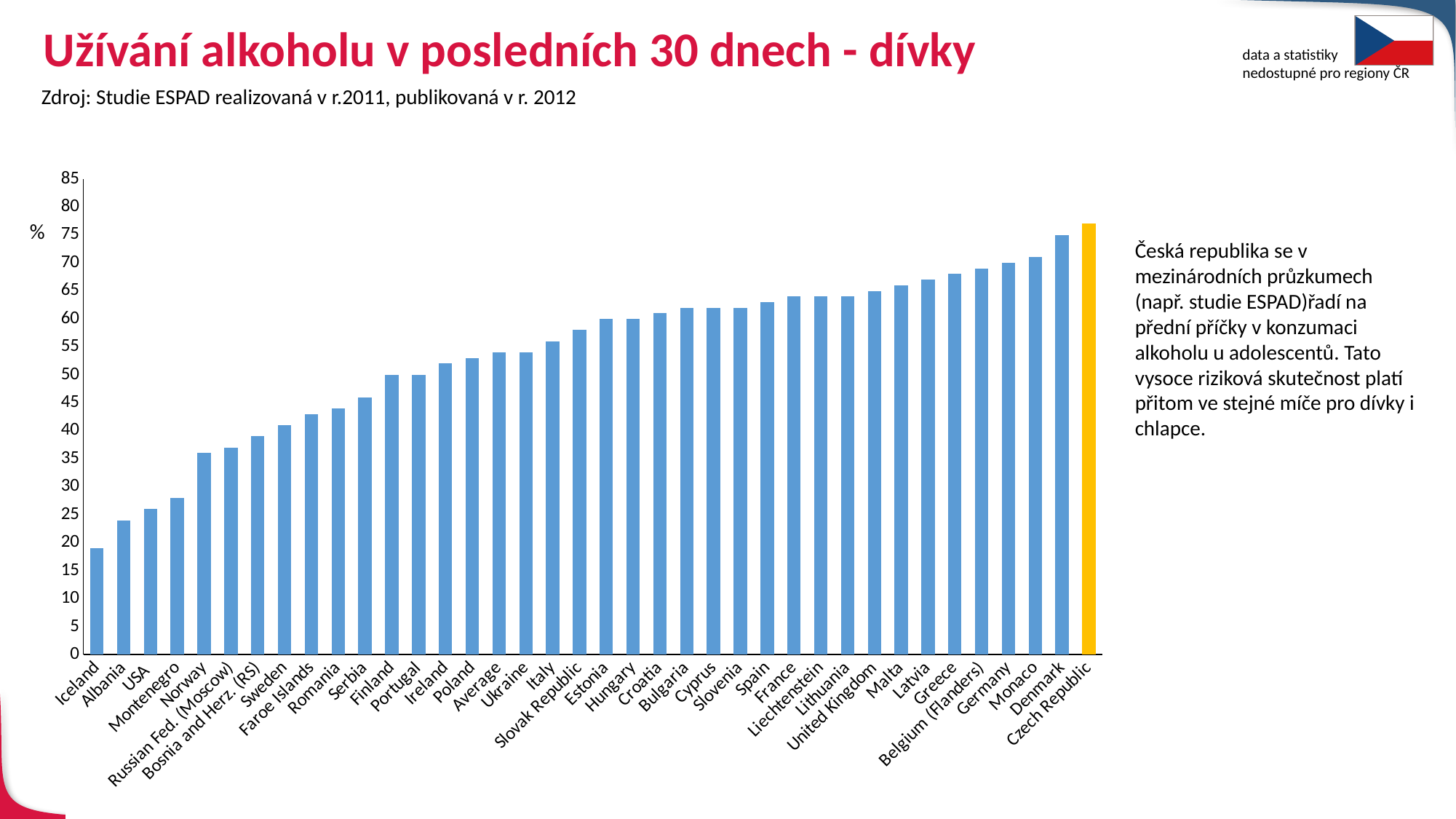
Which has a larger value, Denmark or Monaco? Denmark Which category has the highest value on the chart? Czech Republic Which category has the lowest value on the chart? Iceland What kind of chart is shown on the slide? bar chart How many countries/categories are plotted on the chart? 38 Which bar is highlighted in a different colour (yellow) from the others? Czech Republic Is the value for Spain greater or less than 60? greater Do the values generally rise or fall from left to right along the x axis? rise Is the value for Montenegro greater or less than 30? less Is the value for Greece greater or less than 70? less